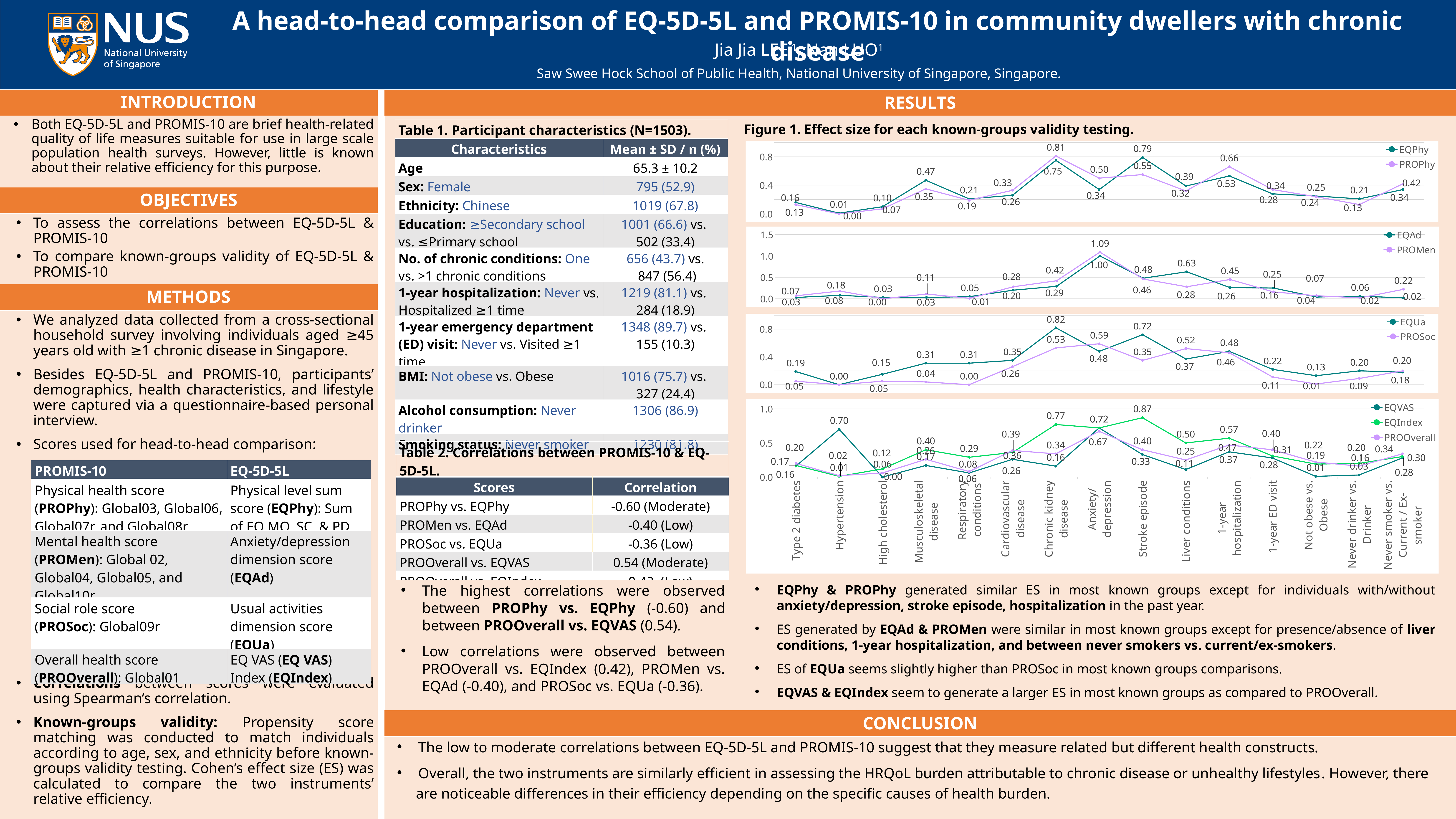
In the third panel of Figure 1, which is larger for chronic kidney disease, the EQUa or the PROSoc effect size? EQUa In the third panel of Figure 1 (EQUa/PROSoc), which known group has the highest effect size? Chronic kidney disease In Figure 1, how many series does the legend of the top panel list? 2 What kind of chart is Figure 1 (Effect size for each known-groups validity testing)? Line chart In the second panel of Figure 1, what is the difference between the EQAd (0.63) and PROMen (0.28) effect sizes for liver conditions? 0.35 In Figure 1, how many series does the legend of the bottom panel list? 3 In Figure 1, which series are listed in the legend of the second panel? EQAd and PROMen In the third panel of Figure 1, what is the EQUa effect size for chronic kidney disease? 0.82 In Figure 1, how many known-group categories are shown along the x axis? 15 In the second panel of Figure 1, what is the EQAd effect size for liver conditions? 0.63 In the second panel of Figure 1 (EQAd/PROMen), what is the highest effect size value shown? 1.09 In the second panel of Figure 1 (EQAd/PROMen), which known group has the highest effect size? Anxiety/depression